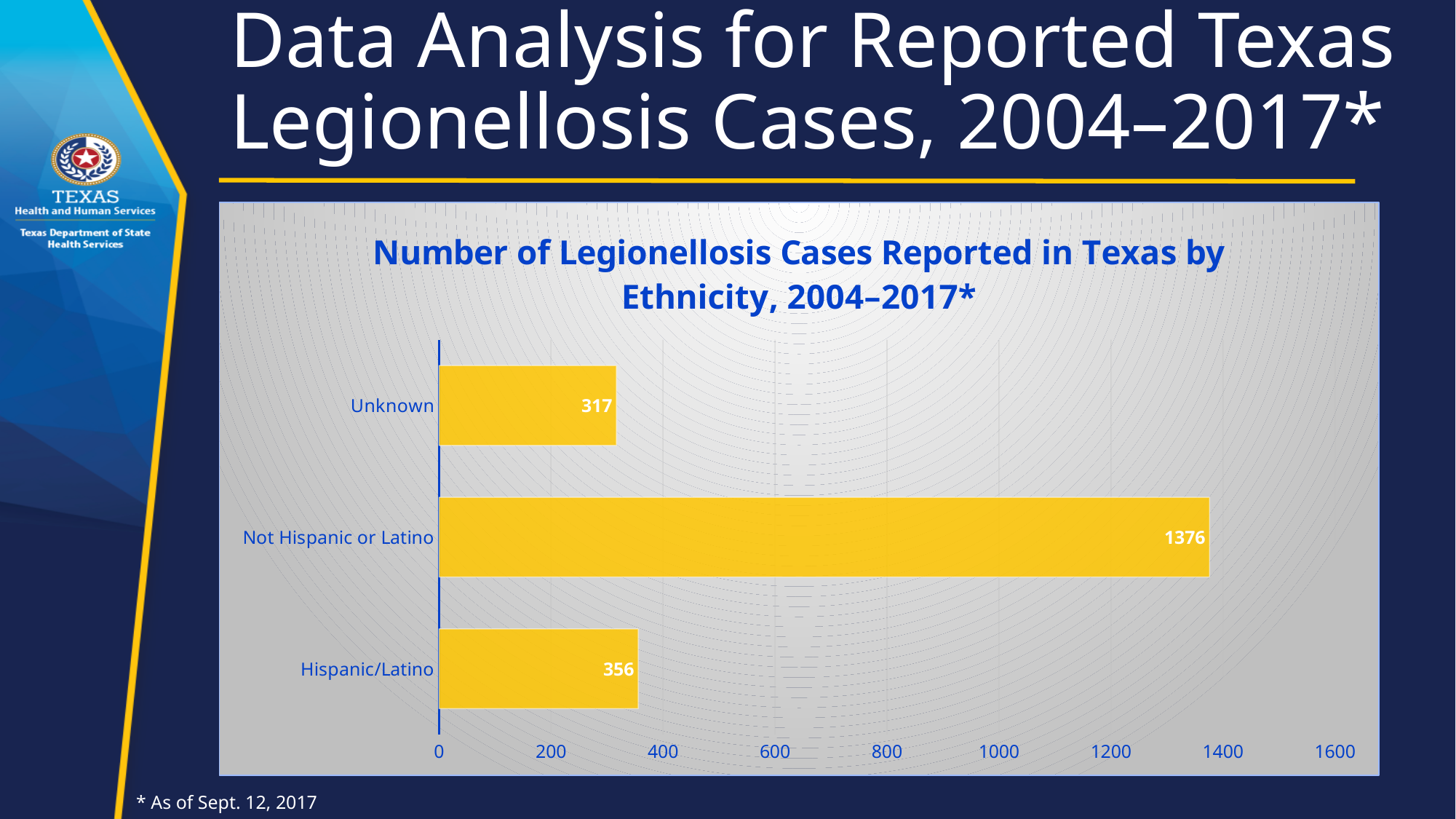
What kind of chart is shown on the slide? Bar chart Which ethnicity category has the highest number of reported cases? Not Hispanic or Latino Is the value for Not Hispanic or Latino greater or less than 1200? greater What is the title of the chart? Number of Legionellosis Cases Reported in Texas by Ethnicity, 2004–2017* How many legionellosis cases were reported for the Hispanic/Latino category? 356 What is the difference in reported cases between Not Hispanic or Latino and Hispanic/Latino? 1020 How many legionellosis cases were reported for the Not Hispanic or Latino category? 1376 Which ethnicity category has the lowest number of reported cases? Unknown How many ethnicity categories are shown in the chart? 3 Which has more reported cases, Hispanic/Latino or Unknown? Hispanic/Latino How many legionellosis cases were reported with Unknown ethnicity? 317 What is the difference in reported cases between Hispanic/Latino and Unknown? 39